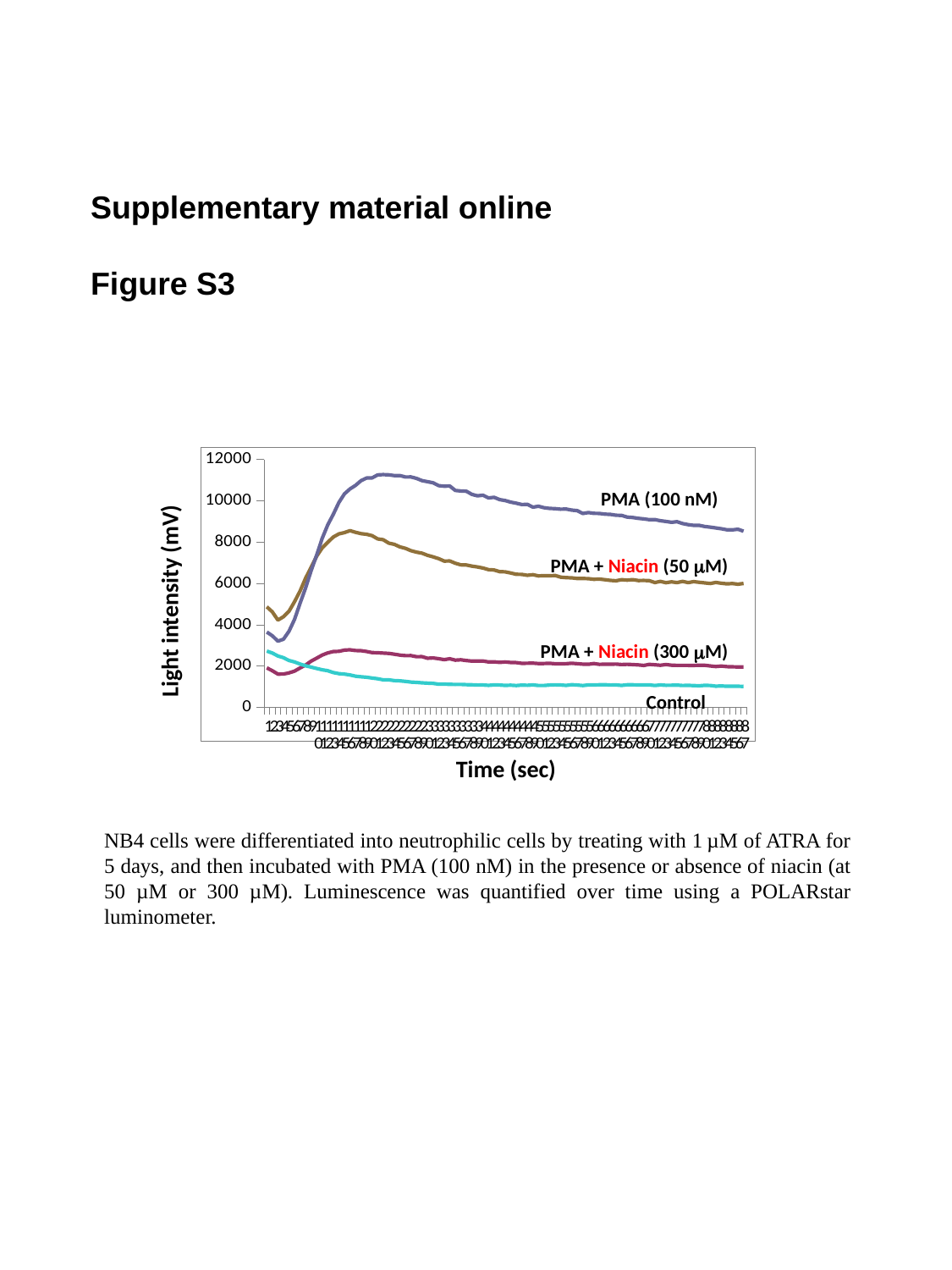
Which series is higher at the end of the time course, PMA (100 nM) or PMA + Niacin (50 μM)? PMA (100 nM) Is the peak value of the PMA (100 nM) series greater or less than 10000? greater Does the Control series rise or fall over time? fall Which series has the lowest light intensity at the end of the time course? Control Is the peak value of the PMA + Niacin (300 μM) series greater or less than 4000? less What is the label of the x-axis? Time (sec) Which series is higher at the end of the time course, Control or PMA + Niacin (300 μM)? PMA + Niacin (300 μM) What is the label of the y-axis? Light intensity (mV) How many series are plotted on the chart? 4 What kind of chart is shown on the slide? line chart Is the peak value of the PMA + Niacin (50 μM) series greater or less than 8000? greater Which series reaches the highest light intensity? PMA (100 nM)